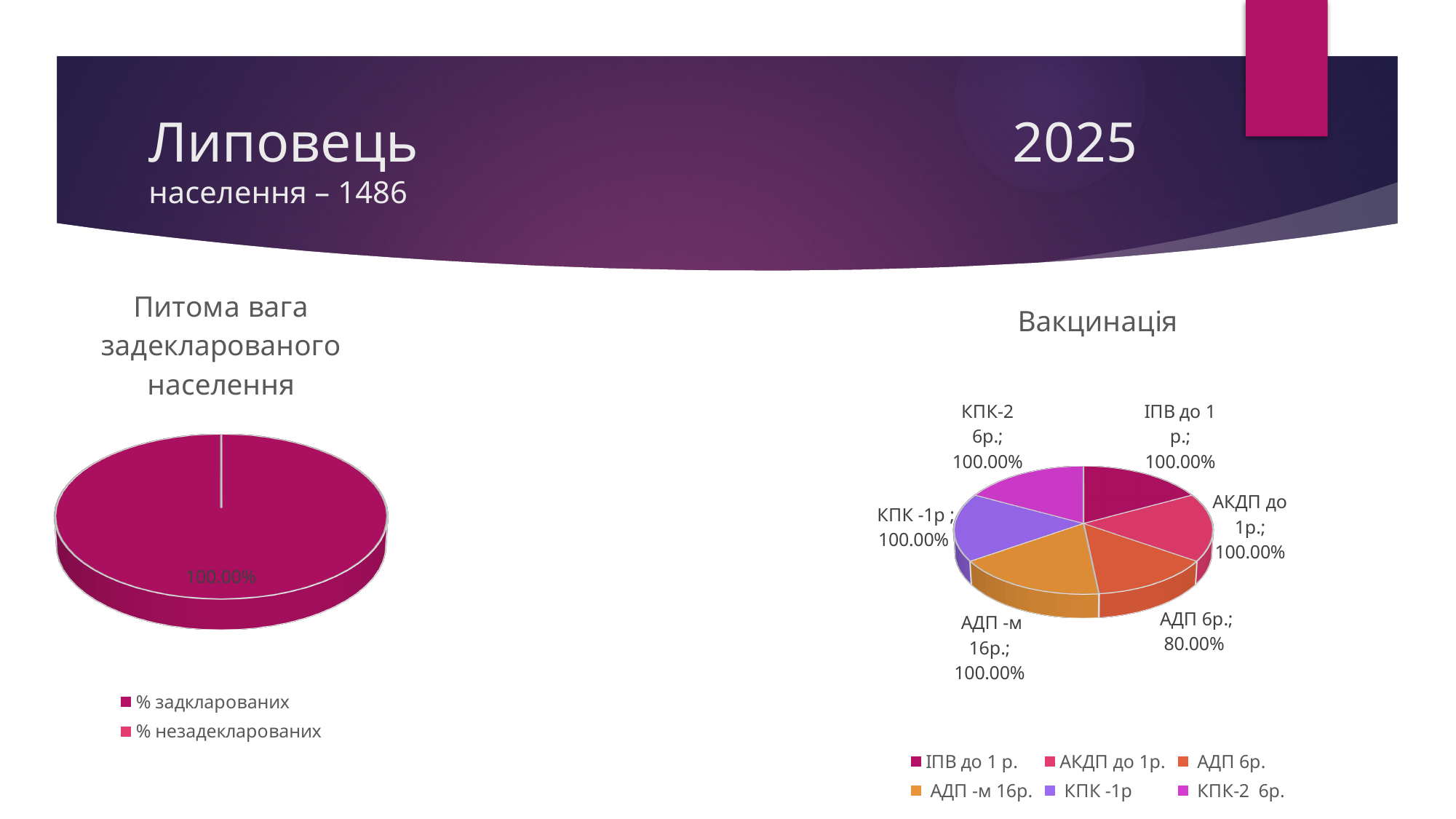
In the 'Вакцинація' chart, which category has the lowest value? АДП 6р. In the 'Вакцинація' chart, what is the difference between the values for АКДП до 1р. and АДП 6р.? 20.00% In the 'Питома вага задекларованого населення' chart, what value is shown on the data label? 100.00% In the 'Вакцинація' chart, what value is shown for ІПВ до 1 р.? 100.00% In the 'Вакцинація' chart, how many entries does the legend list? 6 In the 'Питома вага задекларованого населення' chart, how many entries does the legend list? 2 In the 'Вакцинація' chart, which is larger: the value for АДП -м 16р. or the value for АДП 6р.? АДП -м 16р. What kind of chart is the 'Питома вага задекларованого населення' chart? Pie chart In the 'Вакцинація' chart, what value is shown for АДП 6р.? 80.00% What is the title of the chart on the right side of the slide? Вакцинація In the 'Вакцинація' chart, what value is shown for КПК -1р? 100.00% In the 'Вакцинація' chart, how many categories are plotted? 6